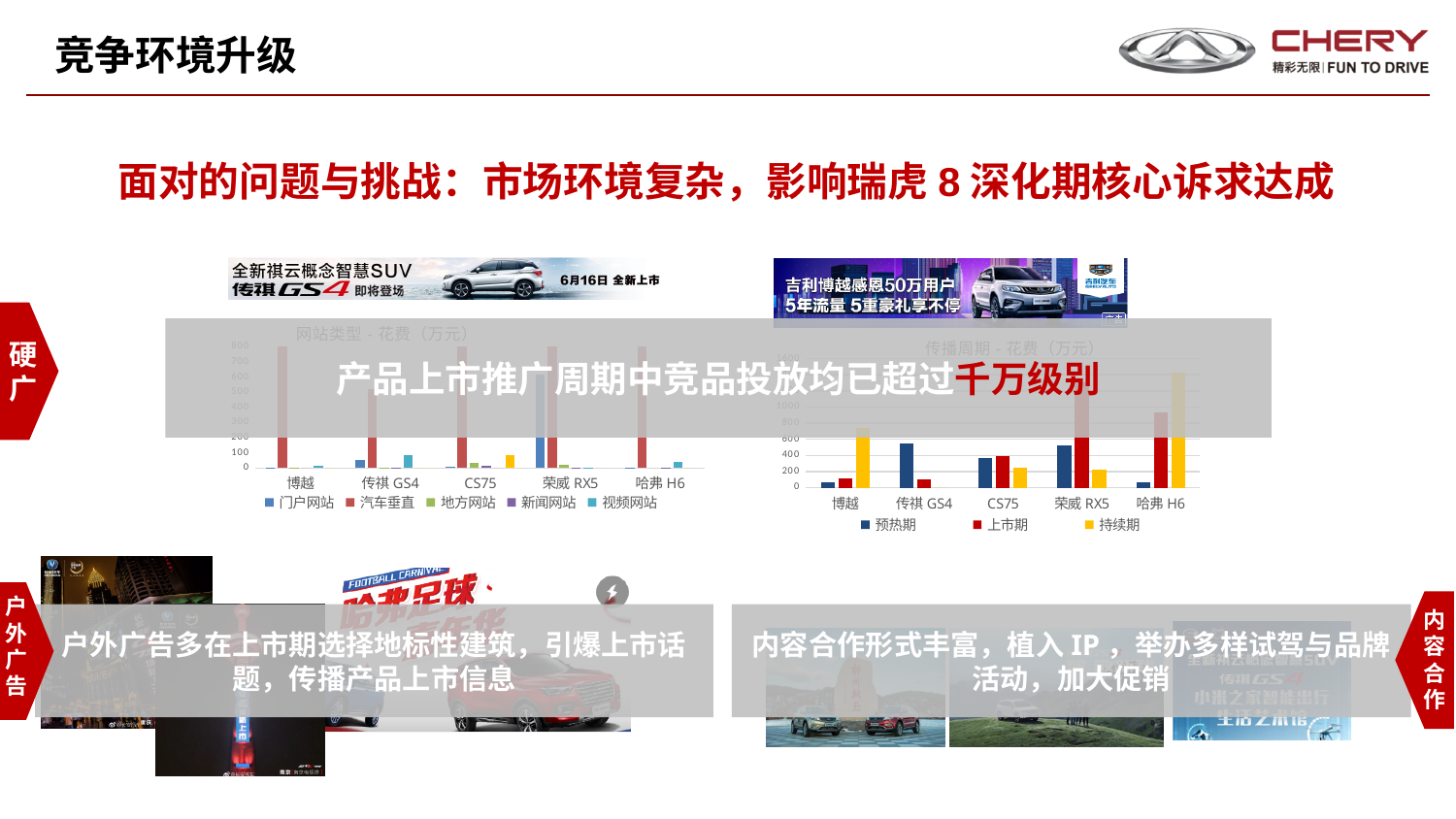
In the left chart (网站类型 - 花费), is the 视频网站 value for 哈弗 H6 greater or less than 100? less In the right chart (传播周期 - 花费), is the 预热期 value for 传祺 GS4 greater or less than 400? greater In the right chart (传播周期 - 花费), is the 预热期 value for 博越 greater or less than 200? less How many categories are shown on the x axis of the right chart (传播周期 - 花费)? 5 In the right chart (传播周期 - 花费), which series has the highest value for 哈弗 H6? 持续期 How many series does the legend of the right chart (传播周期 - 花费) list? 3 What kind of chart is the left chart titled 网站类型 - 花费（万元）? bar chart How many series does the legend of the left chart (网站类型 - 花费) list? 5 In the right chart (传播周期 - 花费), which is larger for 博越: 预热期 or 持续期? 持续期 What kind of chart is the right chart titled 传播周期 - 花费（万元）? bar chart In the left chart (网站类型 - 花费), which series is listed last in the legend? 视频网站 In the right chart (传播周期 - 花费), which series is listed first in the legend? 预热期